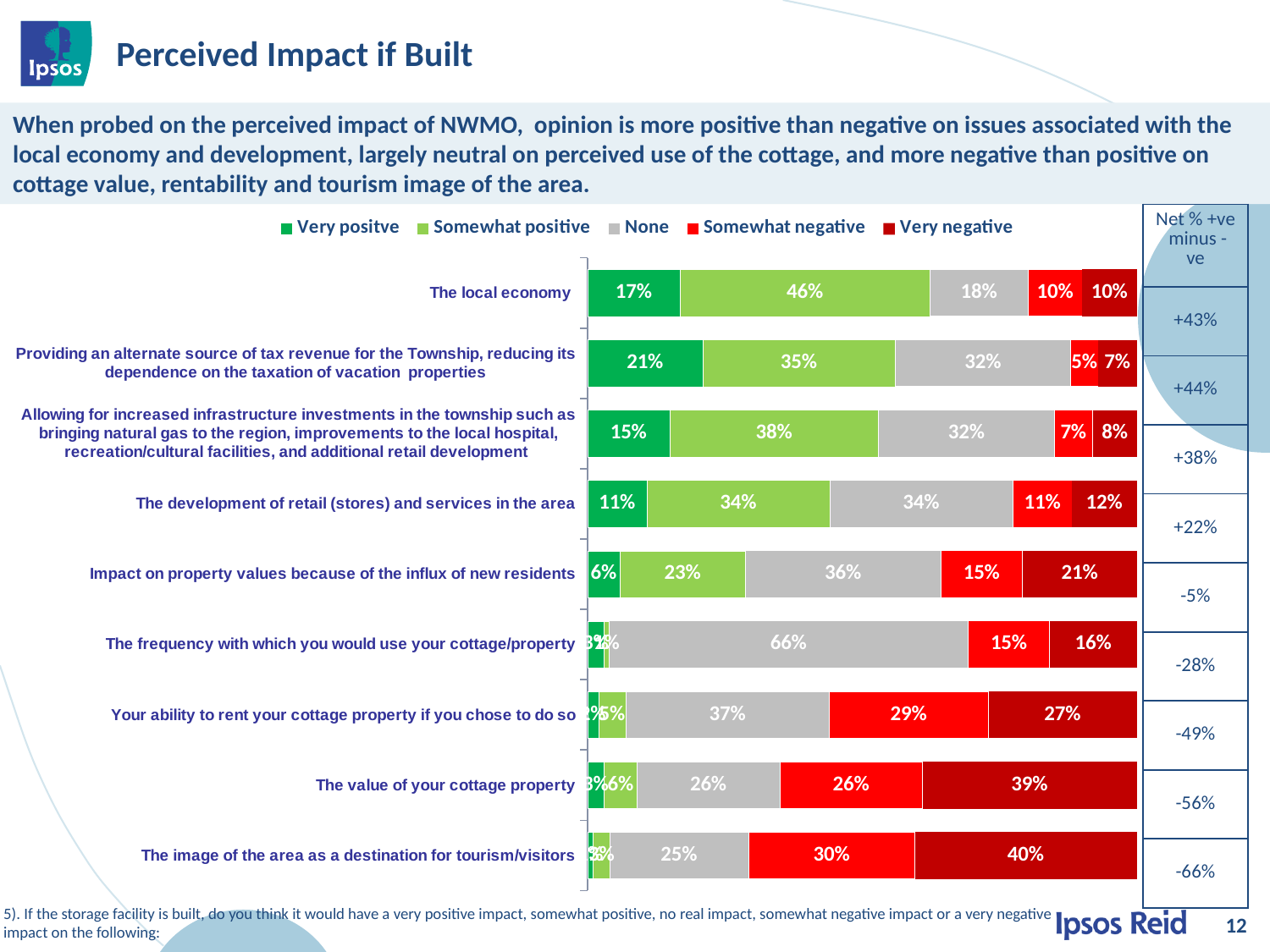
What colour represents 'Very negative' in the legend? Dark red For 'The value of your cottage property', what is the difference between the 'Very negative' and 'Somewhat negative' values? 13 percentage points What is the 'None' value for 'The frequency with which you would use your cottage/property'? 66% What is the 'None' value for 'Impact on property values because of the influx of new residents'? 36% What is the 'Very negative' value for 'The image of the area as a destination for tourism/visitors'? 40% What is the 'Somewhat positive' value for 'The local economy'? 46% What kind of chart is shown on the slide? Stacked bar chart How many series does the legend list? 5 Which has the larger 'Somewhat negative' value: 'Your ability to rent your cottage property if you chose to do so' or 'The development of retail (stores) and services in the area'? Your ability to rent your cottage property if you chose to do so How many categories (issues) are plotted in the chart? 9 Which category has the highest 'Very negative' value? The image of the area as a destination for tourism/visitors Which category has the highest 'Very positive' value? Providing an alternate source of tax revenue for the Township, reducing its dependence on the taxation of vacation properties